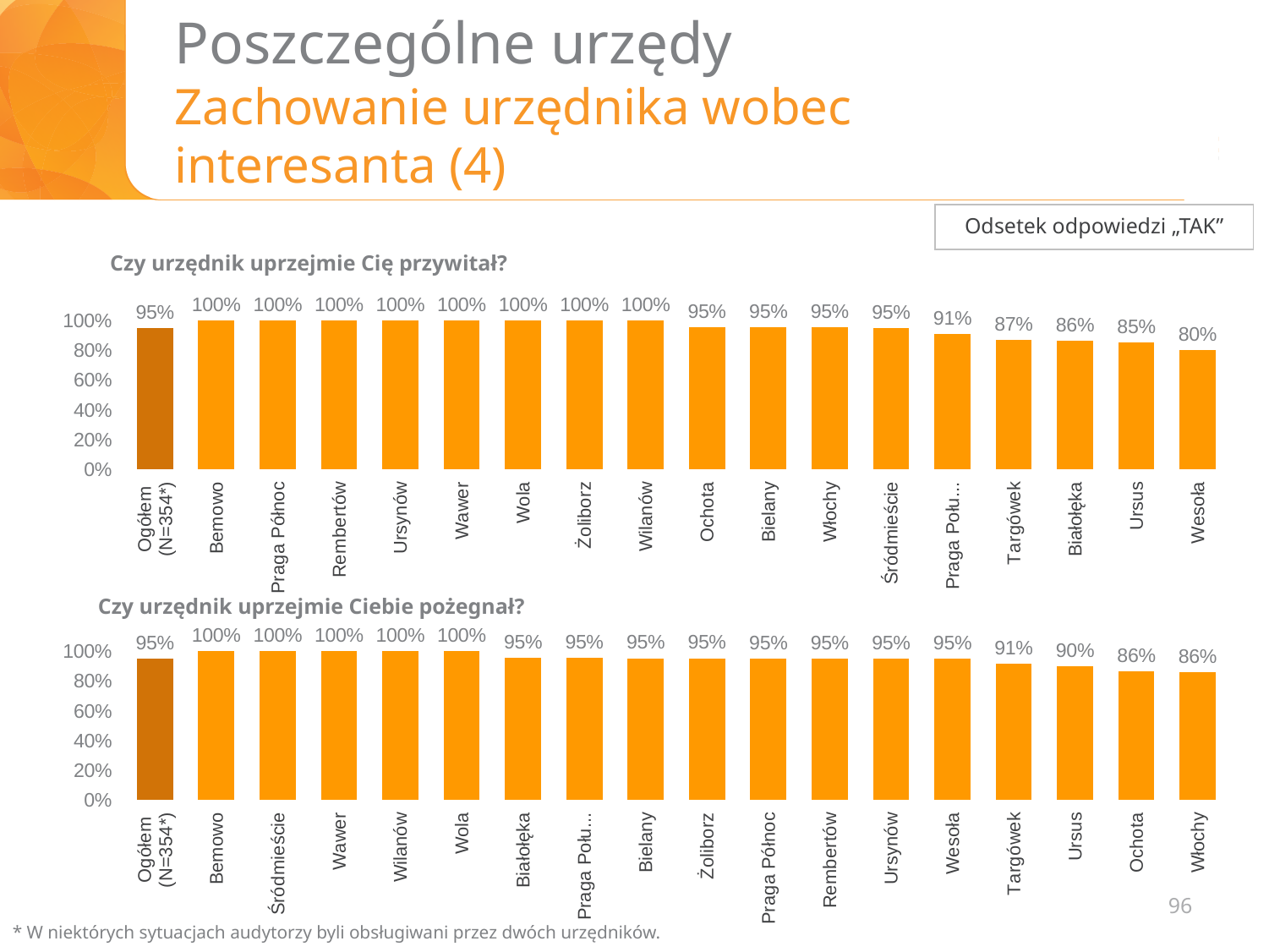
In the chart "Czy urzędnik uprzejmie Cię przywitał?", what is the value for Targówek? 87% In the chart "Czy urzędnik uprzejmie Ciebie pożegnał?", what is the value for Ursus? 90% In the chart "Czy urzędnik uprzejmie Ciebie pożegnał?", what is the difference between the values for Wawer and Włochy? 14% In the chart "Czy urzędnik uprzejmie Cię przywitał?", what is the value for Wesoła? 80% In the chart "Czy urzędnik uprzejmie Cię przywitał?", how many bars are shown? 18 In the chart "Czy urzędnik uprzejmie Cię przywitał?", what is the difference between the values for Bemowo and Ursus? 15% In the chart "Czy urzędnik uprzejmie Cię przywitał?", which is larger, the value for Ochota or the value for Białołęka? Ochota In the chart "Czy urzędnik uprzejmie Ciebie pożegnał?", what is the value for Ogółem (N=354*)? 95% What type of chart is the bottom chart "Czy urzędnik uprzejmie Ciebie pożegnał?"? Bar chart In the chart "Czy urzędnik uprzejmie Cię przywitał?", which category has the lowest value? Wesoła In the chart "Czy urzędnik uprzejmie Ciebie pożegnał?", what is the value for Śródmieście? 100% In the chart "Czy urzędnik uprzejmie Ciebie pożegnał?", which is larger, the value for Targówek or the value for Ochota? Targówek